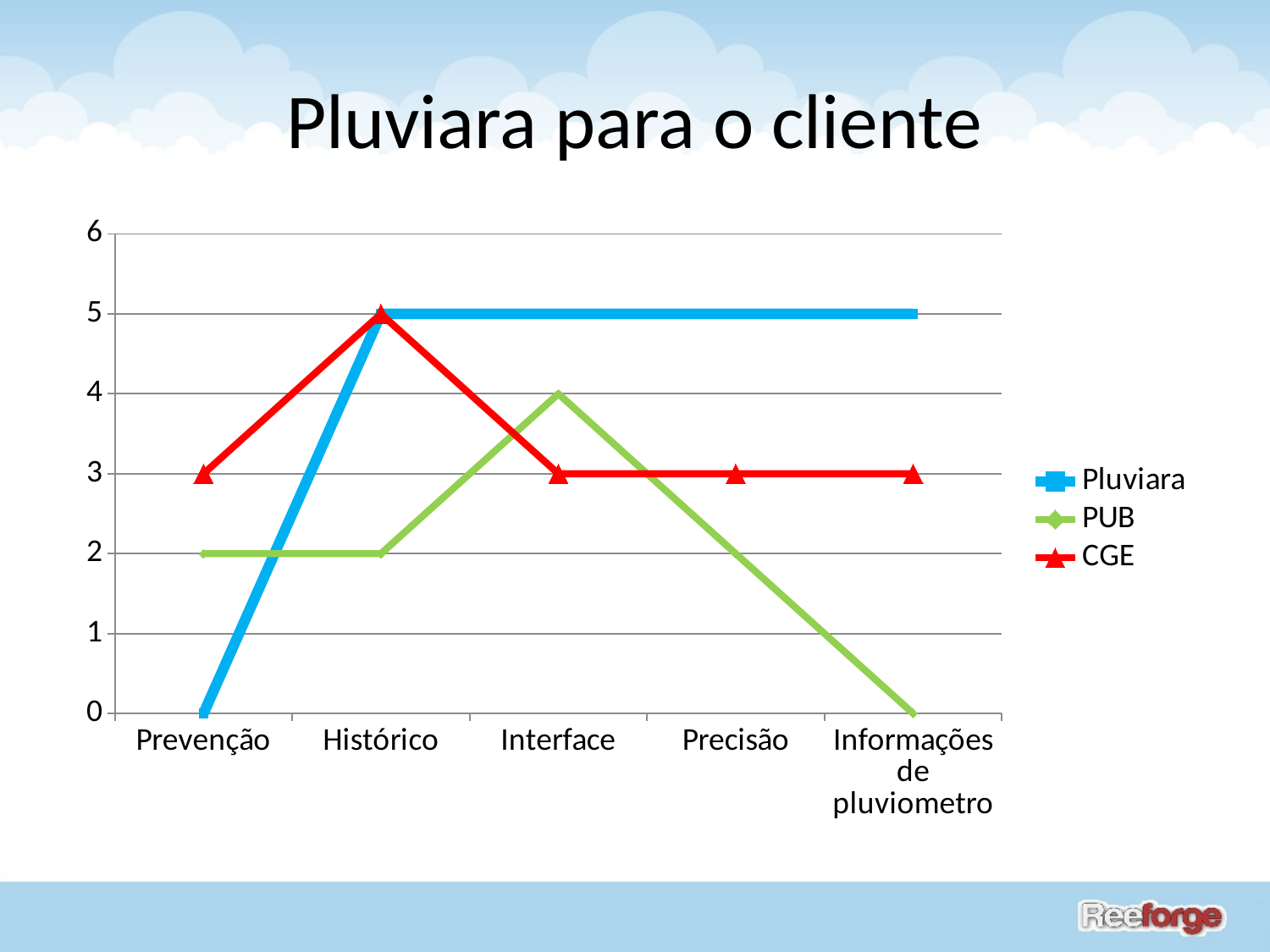
How many categories are shown on the x axis? 5 Which series is drawn in red? CGE At which category does CGE reach its highest value? Histórico What is the value for Pluviara at Histórico? 5 What is the value for PUB at Informações de pluviometro? 0 What is the difference between the Pluviara and CGE values at Interface? 2 What is the value for Pluviara at Prevenção? 0 How many series does the legend list? 3 Which series has the higher value at Precisão, Pluviara or CGE? Pluviara What kind of chart is shown on the slide? line chart What is the value for CGE at Prevenção? 3 What is the value for PUB at Interface? 4